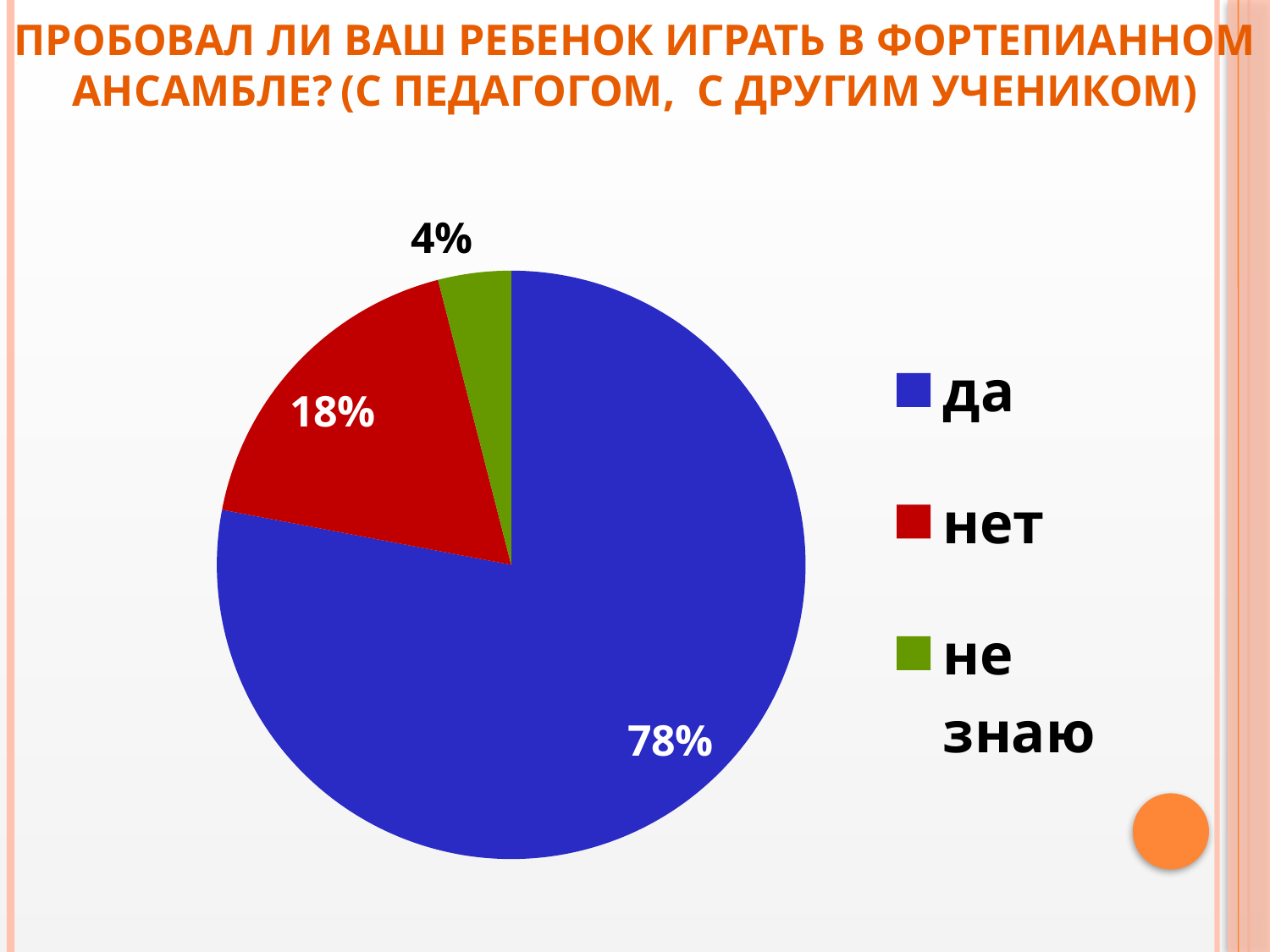
What colour is the slice for "нет"? red What share of the pie does "не знаю" take? 4% What is the difference in percentage points between "да" and "нет"? 60 What share of the pie does "да" take? 78% What is the difference in percentage points between "нет" and "не знаю"? 14 Which category is shown in green in the legend? не знаю Which category has the largest slice of the pie? да What kind of chart is shown on the slide? pie chart Which category has the smallest slice of the pie? не знаю What share of the pie does "нет" take? 18% How many categories are shown in the pie chart? 3 Which is larger, the slice for "нет" or the slice for "не знаю"? нет